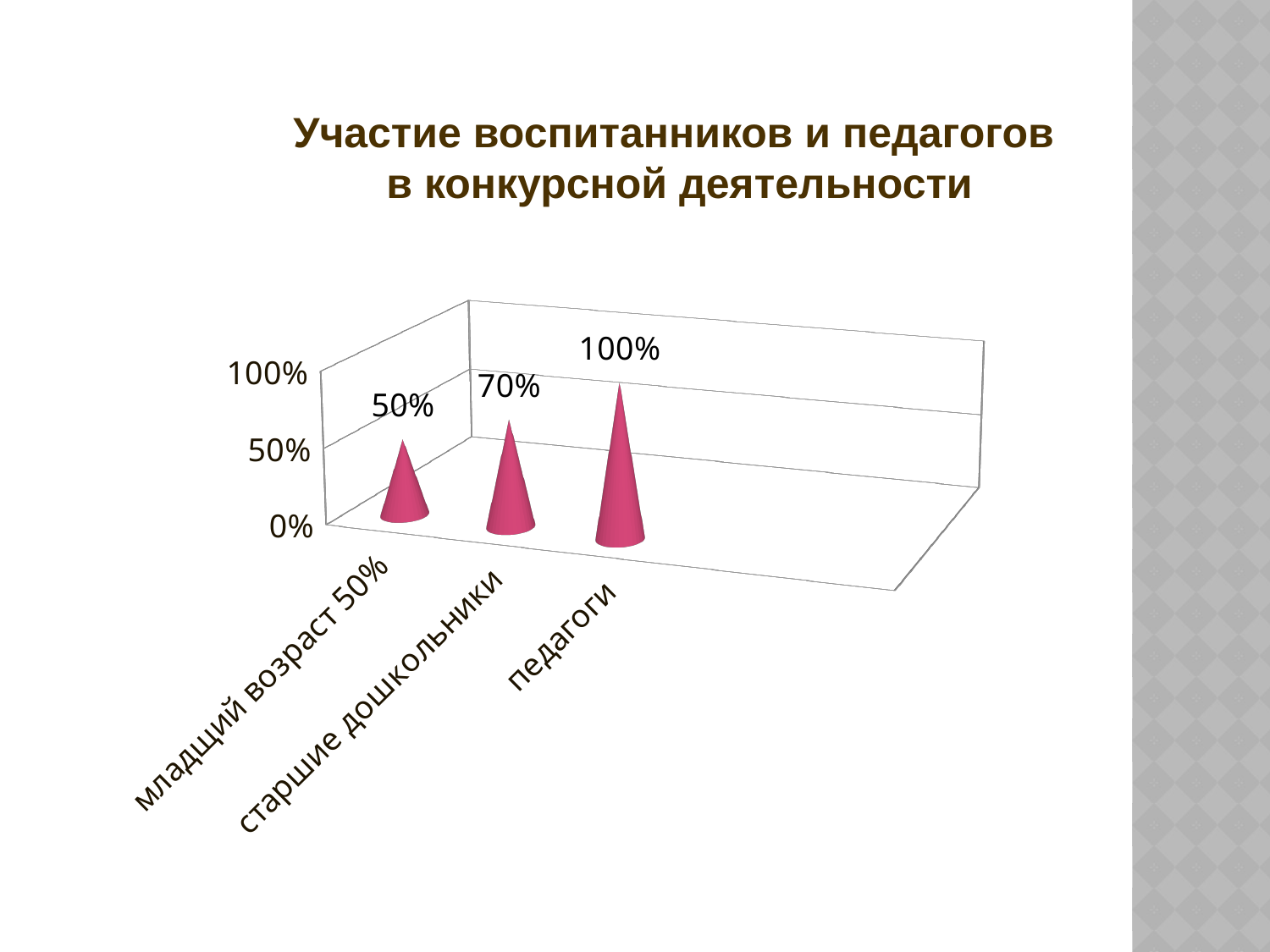
Which category has the lowest value? младщий возраст 50% What is the value for педагоги? 100% Do the values rise or fall from left to right along the x axis? rise What kind of chart is shown on the slide? bar chart Which category has the highest value? педагоги Which is larger, the value for старшие дошкольники or the value for младший возраст 50%? старшие дошкольники What is the title of the slide? Участие воспитанников и педагогов в конкурсной деятельности What is the difference between the values for педагоги and старшие дошкольники? 30% What is the difference between the values for старшие дошкольники and младший возраст 50%? 20% How many categories are shown on the chart? 3 What is the value for старшие дошкольники? 70% What is the value for младший возраст 50%? 50%